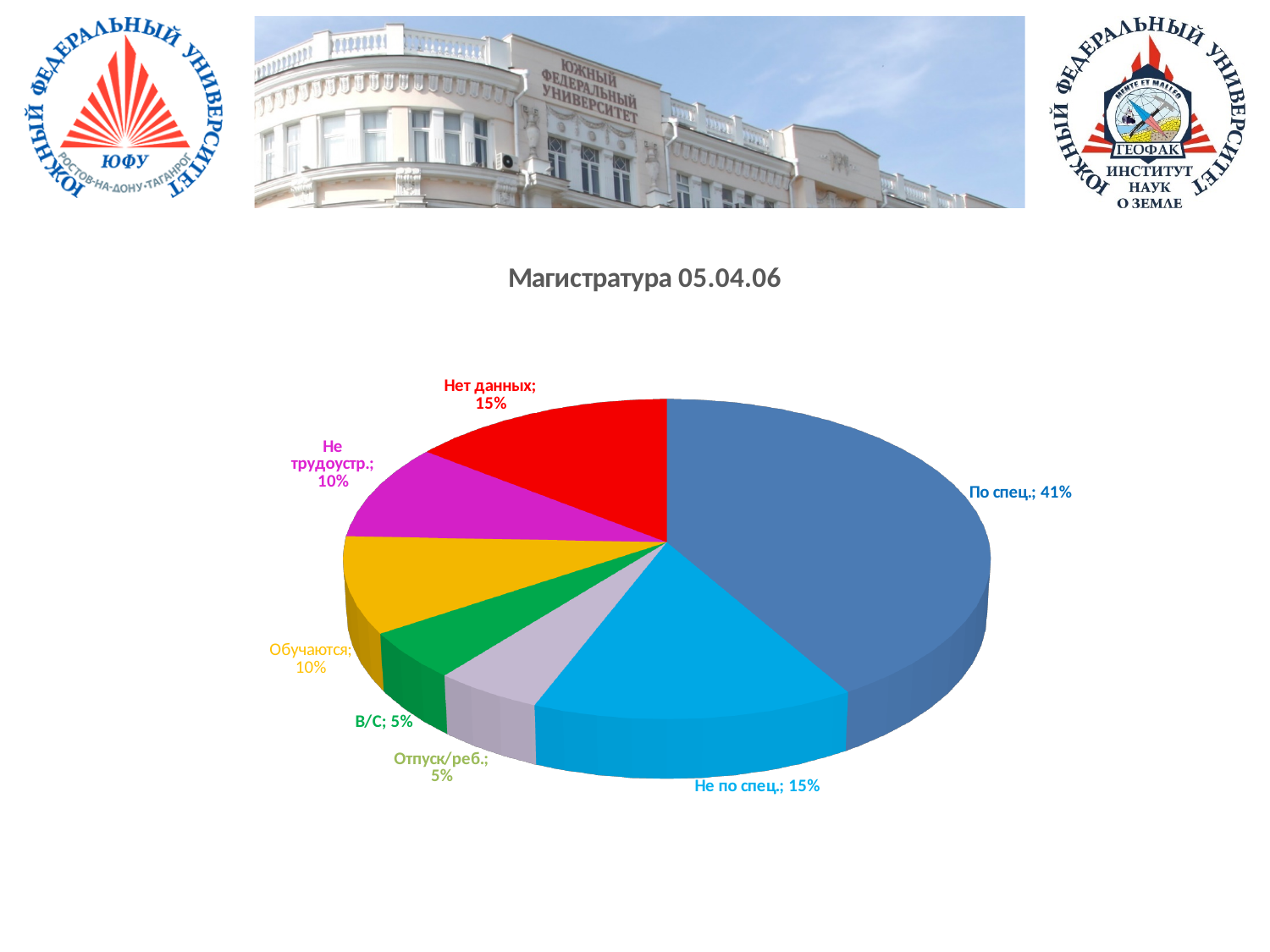
What is the value shown for "Не по спец."? 15% What is the value shown for "В/С"? 5% What is the value shown for "Нет данных"? 15% Which category has the largest slice of the pie? По спец. What is the difference between the "По спец." and "Не по спец." values? 26% What share of the pie does the "По спец." slice represent? 41% How many slices does the pie chart have? 7 What is the title of the chart? Магистратура 05.04.06 What is the value shown for "Обучаются"? 10% What kind of chart is shown on the slide? Pie chart What colour is the "Нет данных" slice? Red Which is larger, the value for "Не трудоустр." or the value for "Отпуск/реб."? Не трудоустр.